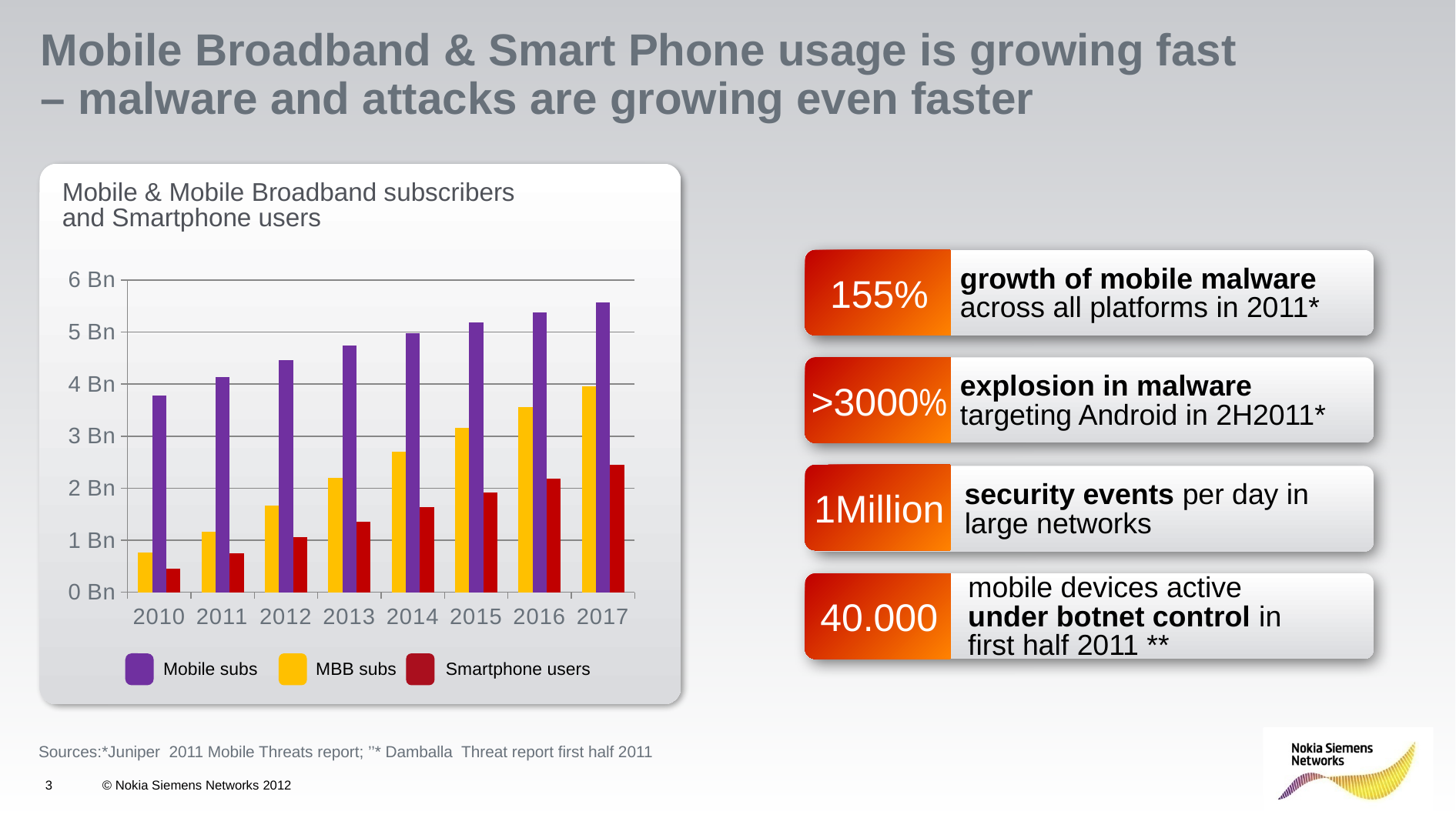
In which year is the Mobile subs bar the highest? 2017 Is the value for MBB subs in 2010 greater or less than 1 Bn? less How many years are shown on the x axis of the chart? 8 Is the value for Mobile subs in 2017 greater or less than 5 Bn? greater Which series is shown in purple in the chart? Mobile subs What is the title of the chart? Mobile & Mobile Broadband subscribers and Smartphone users How many series does the chart legend list? 3 In which year is the Smartphone users bar the lowest? 2010 In 2010, which is larger: Mobile subs or MBB subs? Mobile subs Is the value for Smartphone users in 2017 greater or less than 2 Bn? greater Do the Mobile subs values rise or fall from 2010 to 2017? rise What kind of chart is shown on the slide? bar chart